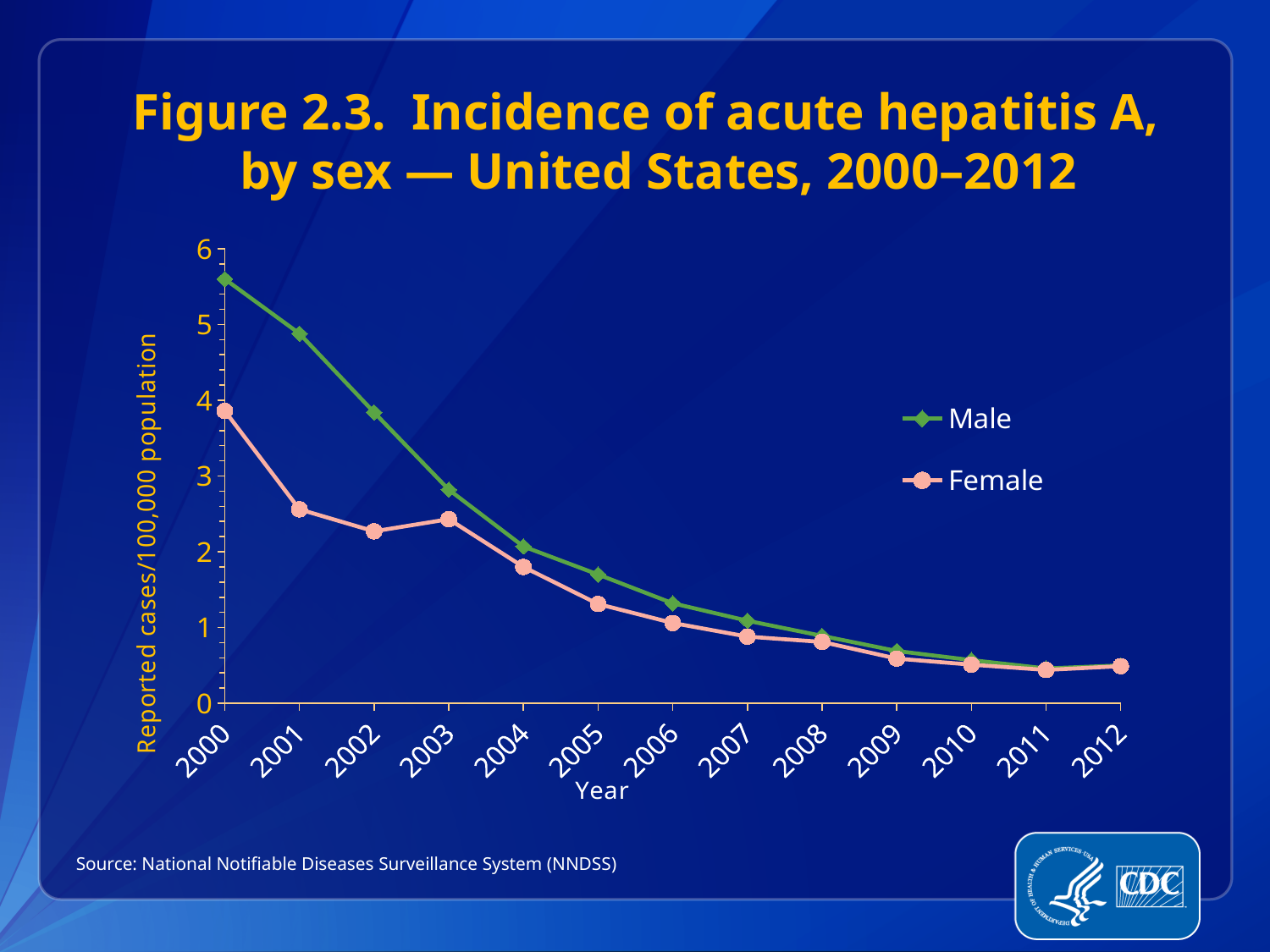
How many years are plotted along the x axis? 13 Is the Male value for 2012 greater or less than 1? less Is the Male value for 2000 greater or less than 5? greater What kind of chart is shown on the slide? line chart Do the Male values generally rise or fall from 2000 to 2012? fall How many series does the legend list? 2 Is the Male value for 2003 greater or less than 3? less What is the label of the y axis? Reported cases/100,000 population In 2001, which series has the higher value, Male or Female? Male In which year is the Female incidence rate highest? 2000 In which year is the Male incidence rate highest? 2000